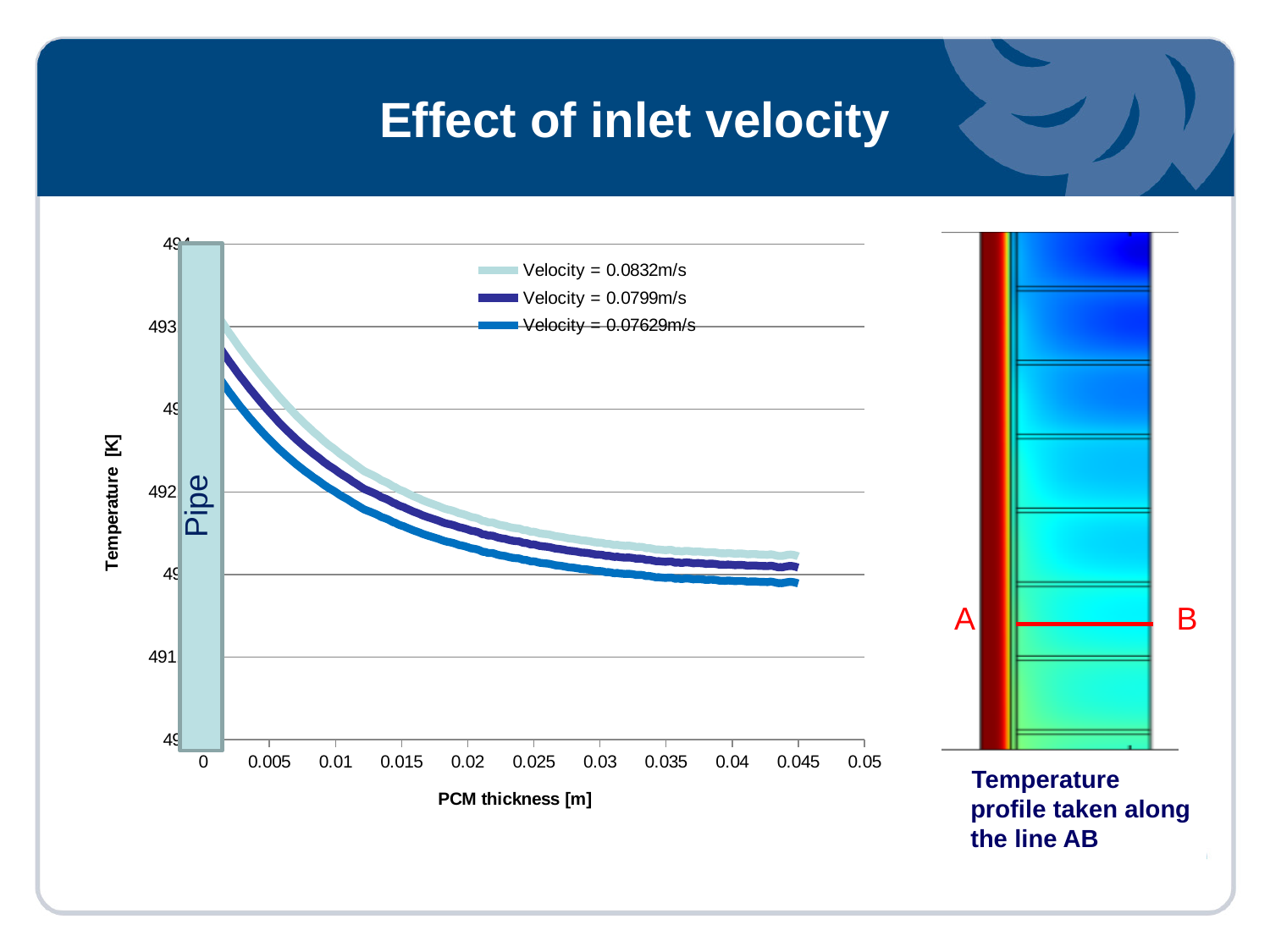
At a PCM thickness of 0.005 m, is the temperature for Velocity = 0.0832m/s greater or less than 492? greater What kind of chart is shown on the slide? line chart At a PCM thickness of 0.01 m, which series has the higher temperature, Velocity = 0.0799m/s or Velocity = 0.07629m/s? Velocity = 0.0799m/s Do the temperature values rise or fall as PCM thickness increases? fall What is the title of the x axis? PCM thickness [m] Which series has the highest temperature across the PCM thickness range? Velocity = 0.0832m/s How many series does the legend list? 3 What is the largest value shown on the x axis? 0.05 What is the title of the y axis? Temperature [K] Which series has the lowest temperature across the PCM thickness range? Velocity = 0.07629m/s